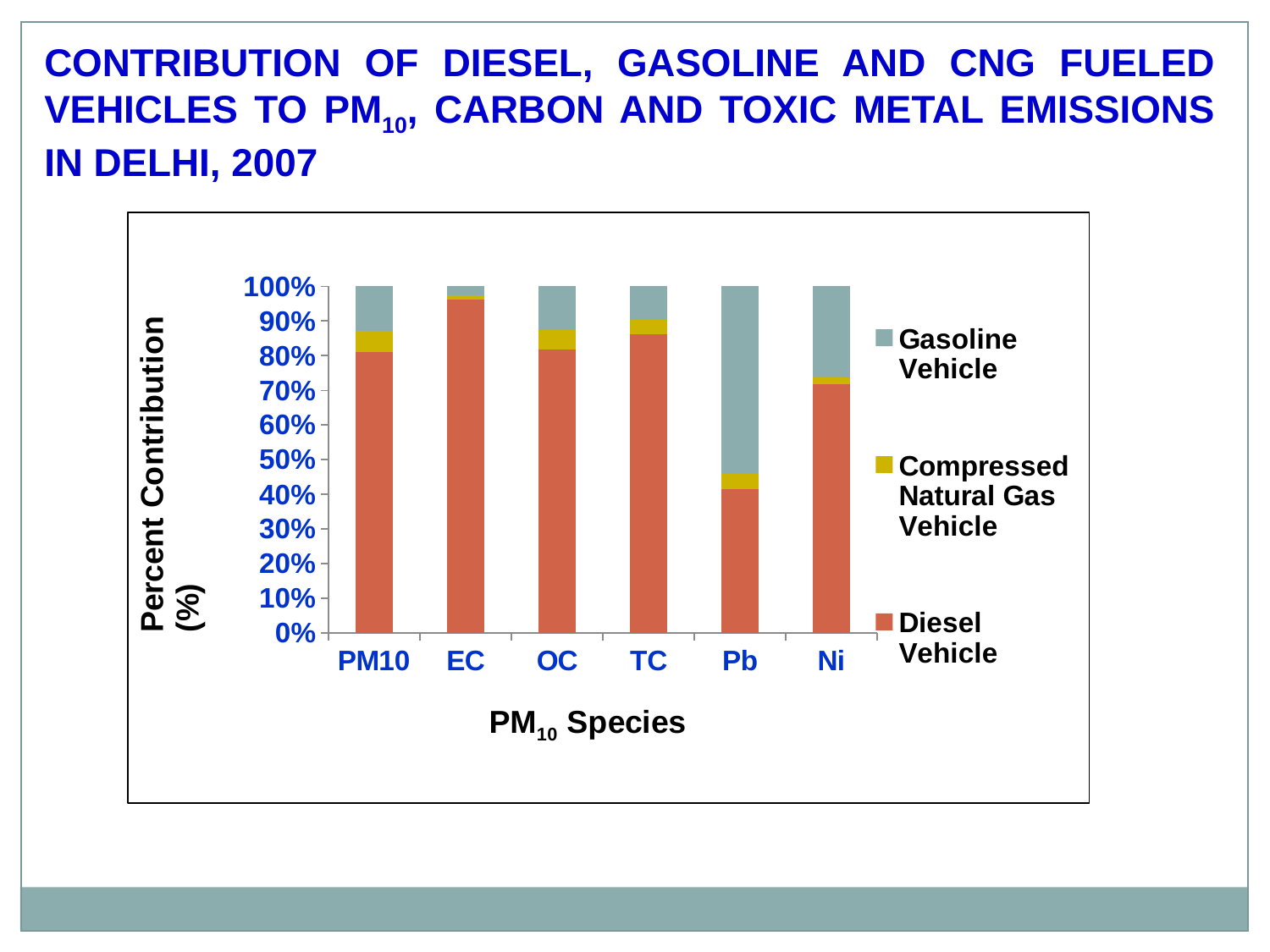
How many PM10 species categories are shown on the x axis? 6 Which species has the largest Gasoline Vehicle contribution? Pb Which has a larger Diesel Vehicle contribution, TC or Ni? TC Is the Diesel Vehicle contribution for Pb greater or less than 50%? less What is the title of the y axis? Percent Contribution (%) Which species has the largest Diesel Vehicle contribution? EC Which species has the smallest Diesel Vehicle contribution? Pb Which has a larger Gasoline Vehicle contribution, Ni or OC? Ni Is the Diesel Vehicle contribution for Ni greater or less than 60%? greater How many series does the legend list? 3 What kind of chart is shown on the slide? Stacked bar chart Is the Diesel Vehicle contribution for EC greater or less than 90%? greater